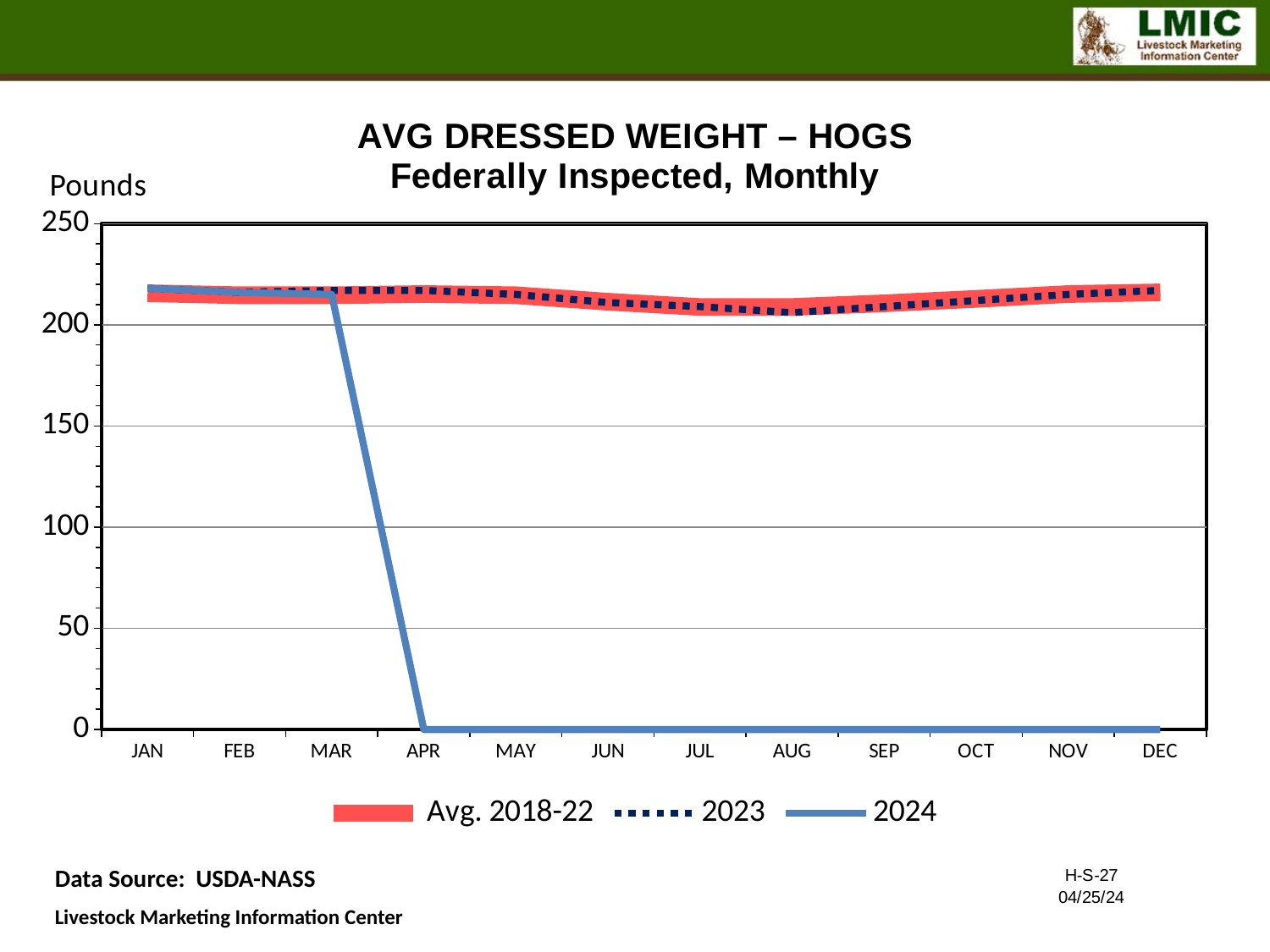
Which is larger for the 2024 series: the value in MAR or the value in APR? MAR Is the value for 2024 in MAR greater or less than 150? greater What is the title of the chart? AVG DRESSED WEIGHT – HOGS Federally Inspected, Monthly How many months are shown along the x axis? 12 Does the 2024 line rise or fall from MAR to APR? fall Is the value for 2023 in AUG greater or less than 200? greater Is the value for Avg. 2018-22 in JAN greater or less than 200? greater What unit is labelled on the y axis? Pounds How many series does the legend list? 3 Which is larger for the 2023 series: the value in JAN or the value in AUG? JAN What kind of chart is shown on the slide? line chart What value does the 2024 line show for APR? 0